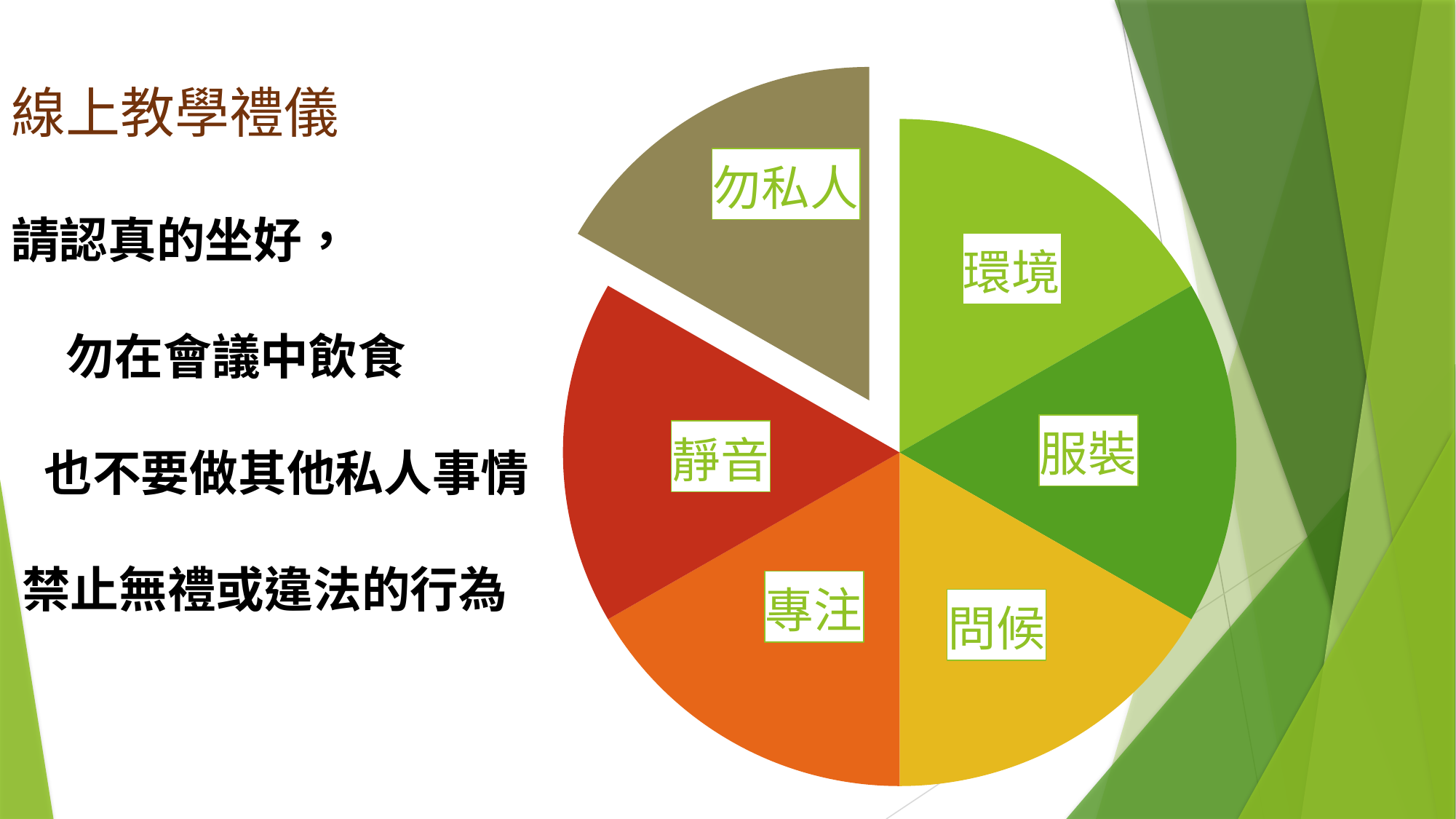
Which slice label appears in the dark green slice on the right side of the pie chart? 服裝 How many slices does the pie chart have? 6 Which slice label appears in the yellow slice at the bottom right of the pie chart? 問候 What colour is the slice labelled 靜音 in the pie chart? dark red Which slice of the pie chart is pulled out (exploded) from the rest of the pie? 勿私人 Which slice label appears in the orange slice at the bottom left of the pie chart? 專注 What kind of chart is shown on the slide? pie chart Which slice label appears in the light green slice at the top right of the pie chart? 環境